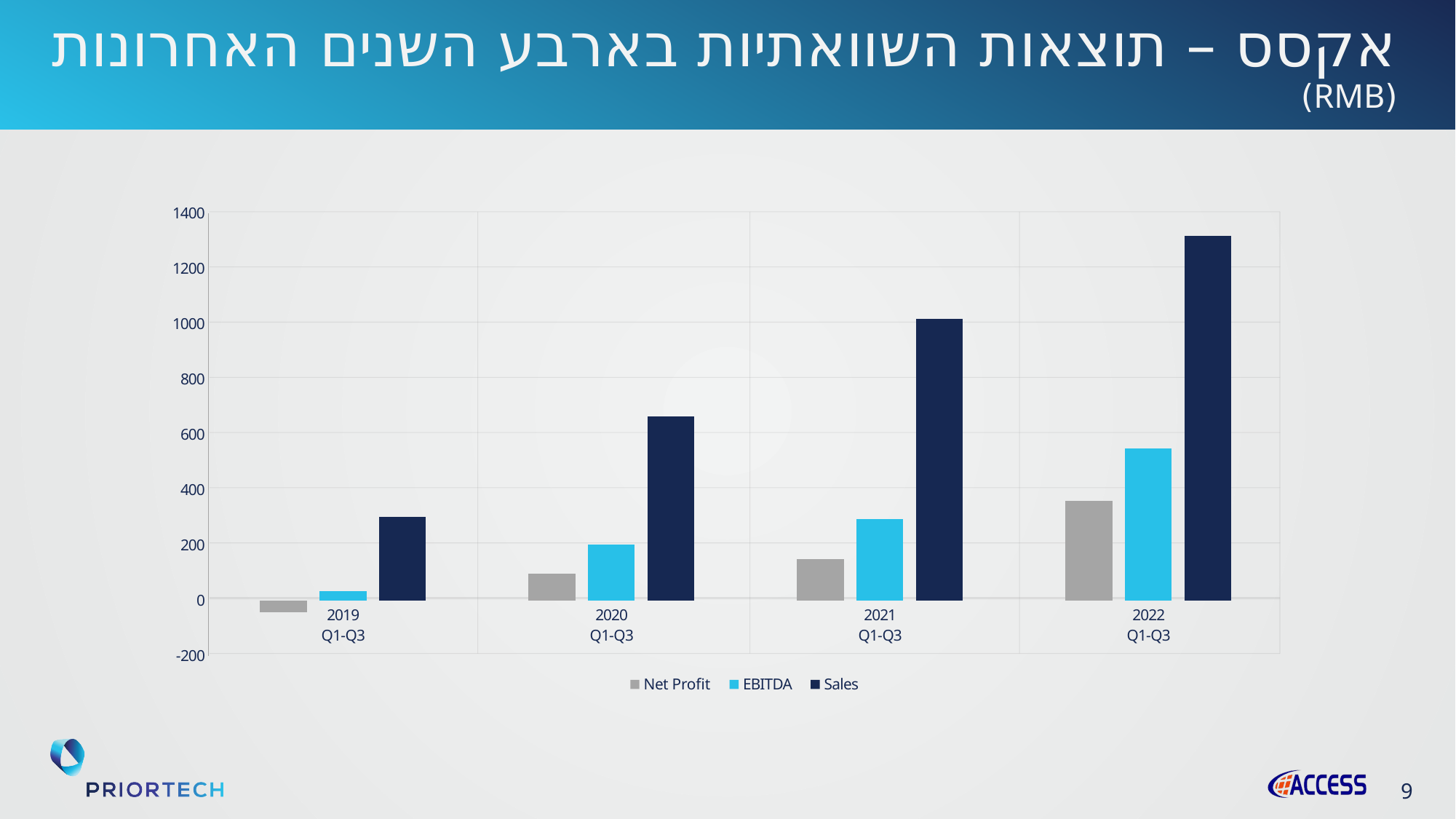
In which period is Sales highest? 2022 Q1-Q3 What kind of chart is shown on the slide? bar chart Is the value for Net Profit in 2019 Q1-Q3 greater or less than 0? less Is the value for Sales in 2021 Q1-Q3 greater or less than 800? greater Is the value for Sales in 2022 Q1-Q3 greater or less than 1200? greater Do Sales rise or fall from 2019 Q1-Q3 to 2022 Q1-Q3? rise Which is larger: EBITDA in 2022 Q1-Q3 or Sales in 2020 Q1-Q3? Sales in 2020 Q1-Q3 How many series does the legend list? 3 How many periods (categories) are shown on the x axis? 4 In which period is Net Profit lowest? 2019 Q1-Q3 Which series is shown in dark navy bars? Sales